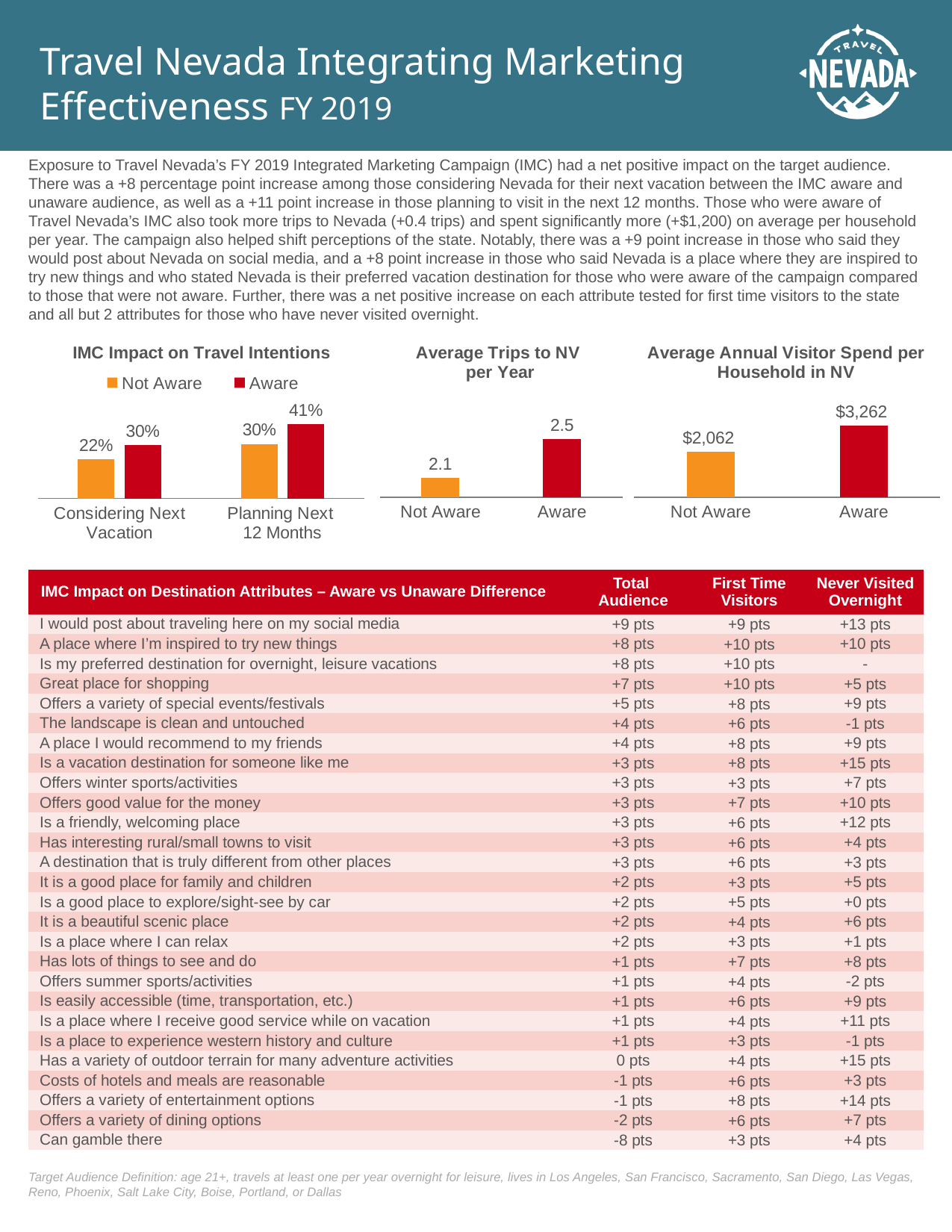
In the 'Average Annual Visitor Spend per Household in NV' chart, which category has the higher value? Aware In the 'Average Annual Visitor Spend per Household in NV' chart, what is the difference between Aware and Not Aware? $1,200 In the 'IMC Impact on Travel Intentions' chart, what is the Aware value for Planning Next 12 Months? 41% In the 'IMC Impact on Travel Intentions' chart, what is the difference between the Aware and Not Aware values for Considering Next Vacation? 8 percentage points What type of chart is 'Average Annual Visitor Spend per Household in NV'? Bar chart In the 'Average Annual Visitor Spend per Household in NV' chart, what is the value for Not Aware? $2,062 In the 'Average Trips to NV per Year' chart, what is the difference between Aware and Not Aware? 0.4 In the 'IMC Impact on Travel Intentions' chart, what is the Not Aware value for Considering Next Vacation? 22% In the 'Average Trips to NV per Year' chart, what is the value for Aware? 2.5 In the 'IMC Impact on Travel Intentions' chart, how many series does the legend list? 2 In the 'Average Trips to NV per Year' chart, which category has the lower value? Not Aware In the 'IMC Impact on Travel Intentions' chart, which series is shown in orange? Not Aware